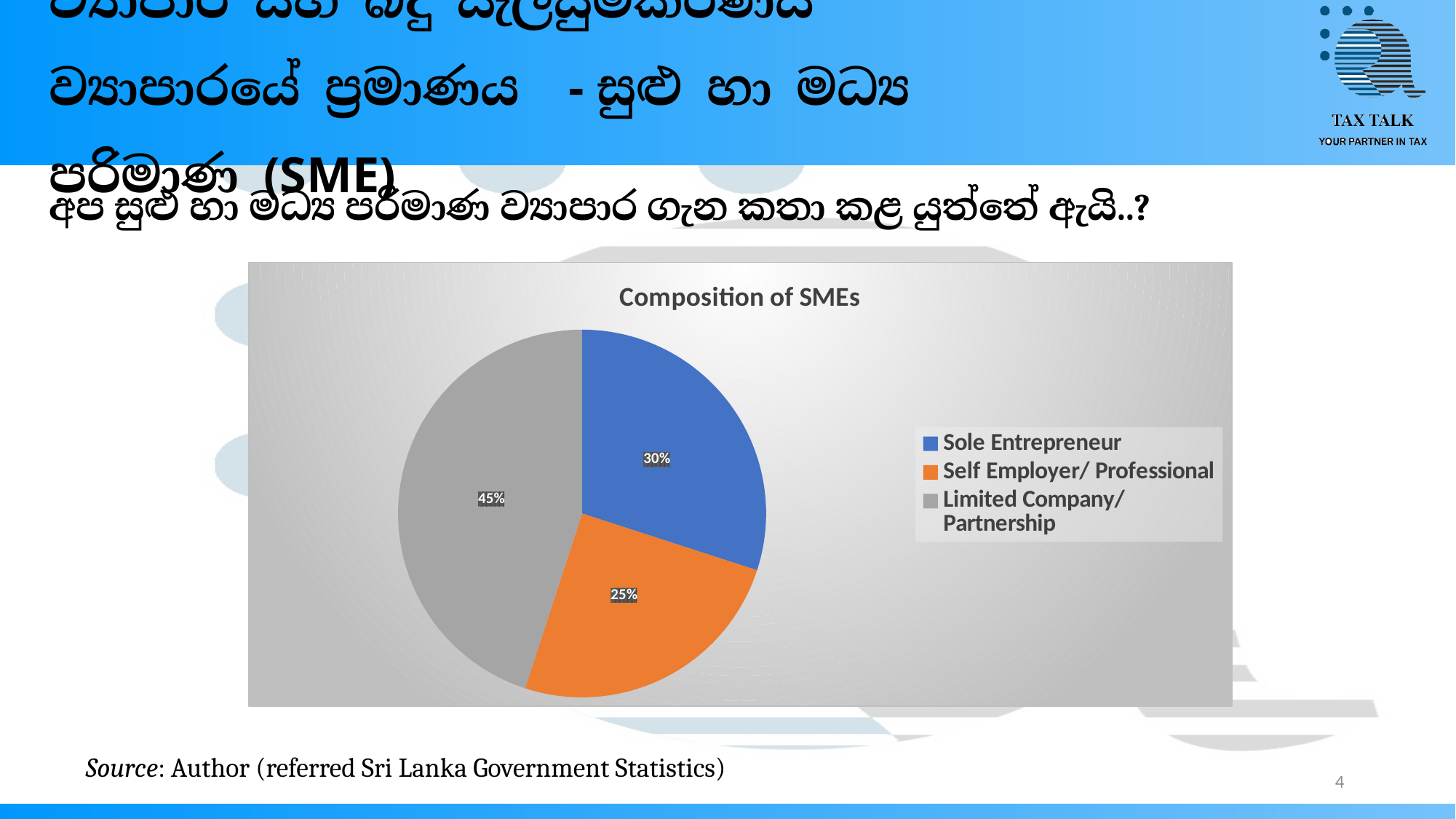
Which category has the largest share of the pie? Limited Company/ Partnership What colour is the Self Employer/ Professional slice? Orange Which is larger, the share for Sole Entrepreneur or the share for Self Employer/ Professional? Sole Entrepreneur How many categories does the pie chart show? 3 What share of SMEs is Limited Company/ Partnership? 45% What kind of chart is shown on the slide? Pie chart What is the title of the chart? Composition of SMEs Which category has the smallest share of the pie? Self Employer/ Professional What is the difference in percentage points between Limited Company/ Partnership and Sole Entrepreneur? 15% What is the combined share of Sole Entrepreneur and Self Employer/ Professional? 55% What share of SMEs is Self Employer/ Professional? 25% What share of SMEs is Sole Entrepreneur? 30%